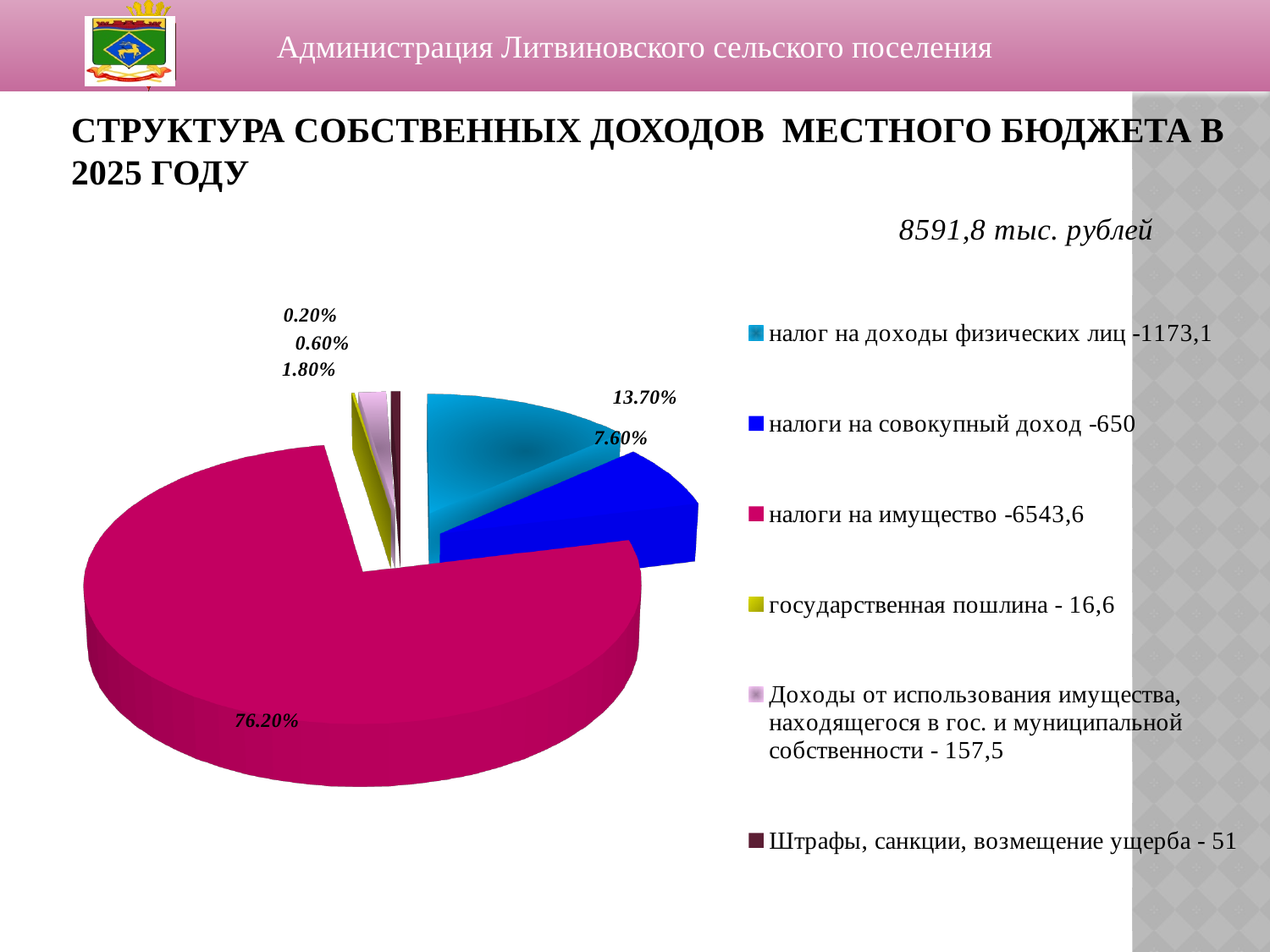
What share of the pie does "налоги на совокупный доход" take? 7.60% What is the difference between the legend values for "налог на доходы физических лиц" (1173,1) and "налоги на совокупный доход" (650)? 523,1 What kind of chart is shown on the slide? pie chart What value is given in the legend for "налоги на имущество"? 6543,6 How many slices does the pie chart have? 6 What value is given in the legend for "государственная пошлина"? 16,6 What share of the pie does "налоги на имущество" take? 76.20% Which category has the smallest value according to the legend? государственная пошлина Which is larger, "налог на доходы физических лиц" or "налоги на совокупный доход"? налог на доходы физических лиц Which category has the largest slice of the pie? налоги на имущество What total amount is stated above the chart? 8591,8 тыс. рублей What share of the pie does "налог на доходы физических лиц" take? 13.70%